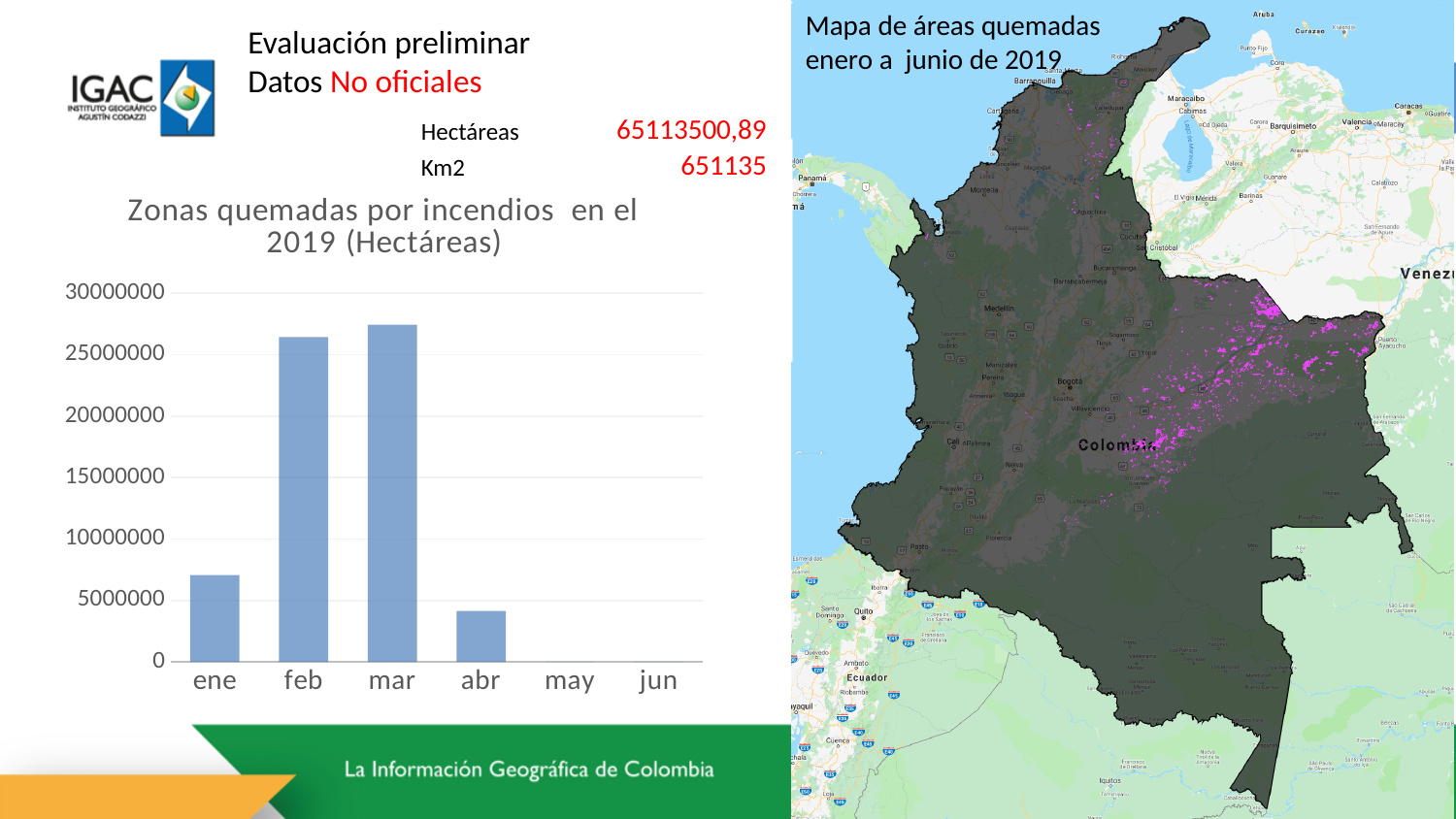
Do the values rise or fall from mar to abr? fall Which is larger, the value for ene or the value for abr? ene How many months are shown on the x axis of the chart? 6 What is the highest tick value shown on the vertical axis of the chart? 30000000 What kind of chart is used to show 'Zonas quemadas por incendios en el 2019 (Hectáreas)'? bar chart Which month has the highest bar in the chart? mar Is the value for ene greater or less than 10000000? less Is the value for ene greater or less than 5000000? greater Which is larger, the value for feb or the value for abr? feb Is the value for mar greater or less than 30000000? less